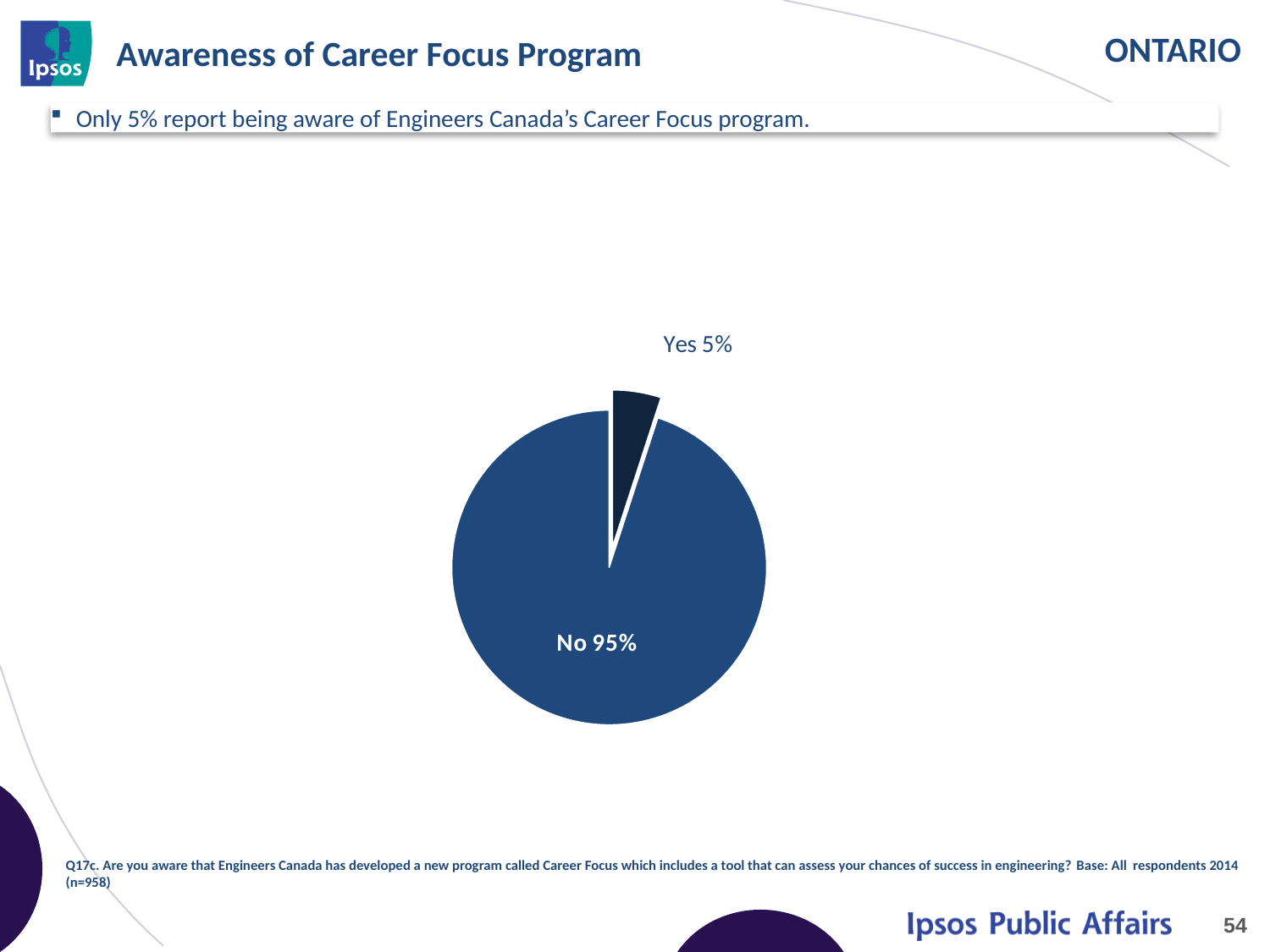
What percentage of respondents answered "Yes"? 5% Which slice of the pie is the largest? No What kind of chart is shown on the slide? pie chart What share of the pie does the "Yes" slice represent? 5% What is the title of the slide containing the pie chart? Awareness of Career Focus Program What is the difference in percentage points between the "No" and "Yes" slices? 90 Which is larger, the "Yes" slice or the "No" slice? No What percentage of respondents answered "No"? 95% Which slice is shown in the darker navy colour? Yes How many slices does the pie chart have? 2 Which slice of the pie is the smallest? Yes